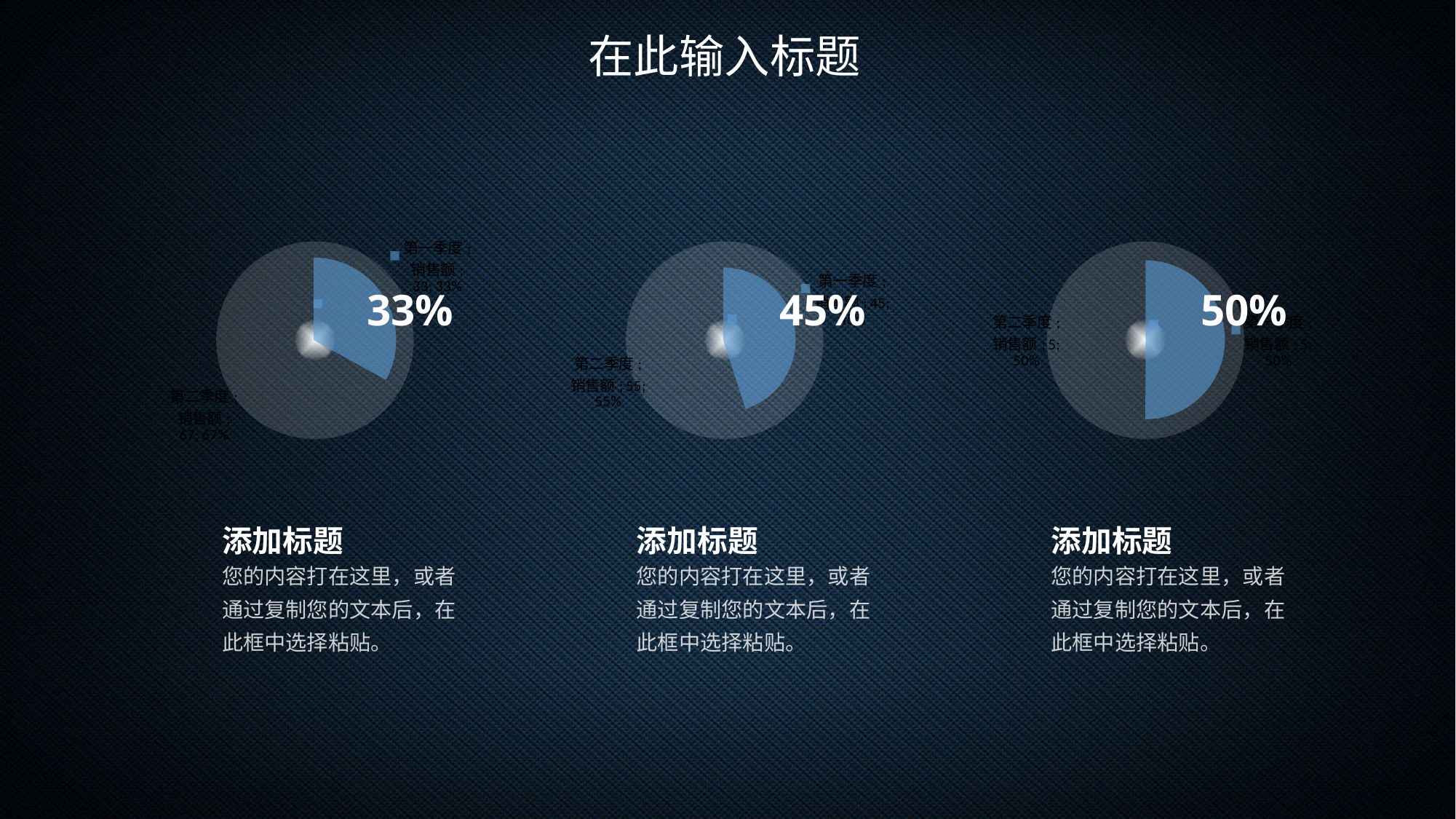
What percentage is displayed on the right pie chart? 50% How many pie charts are on the slide? 3 What percentage is displayed on the left pie chart? 33% Which pie chart shows the lowest percentage: left, middle or right? Left What colour is the highlighted slice in each pie chart? Blue What percentage is displayed on the middle pie chart? 45% Which pie chart shows the highest percentage: left, middle or right? Right What share of the right pie chart does the highlighted slice cover? 50% What kind of chart is used on this slide? Pie chart What is the difference between the percentage on the right pie chart and the percentage on the middle pie chart? 5% What is the difference between the percentage on the middle pie chart and the percentage on the left pie chart? 12% Which is larger, the percentage on the left pie chart or the percentage on the middle pie chart? Middle pie chart